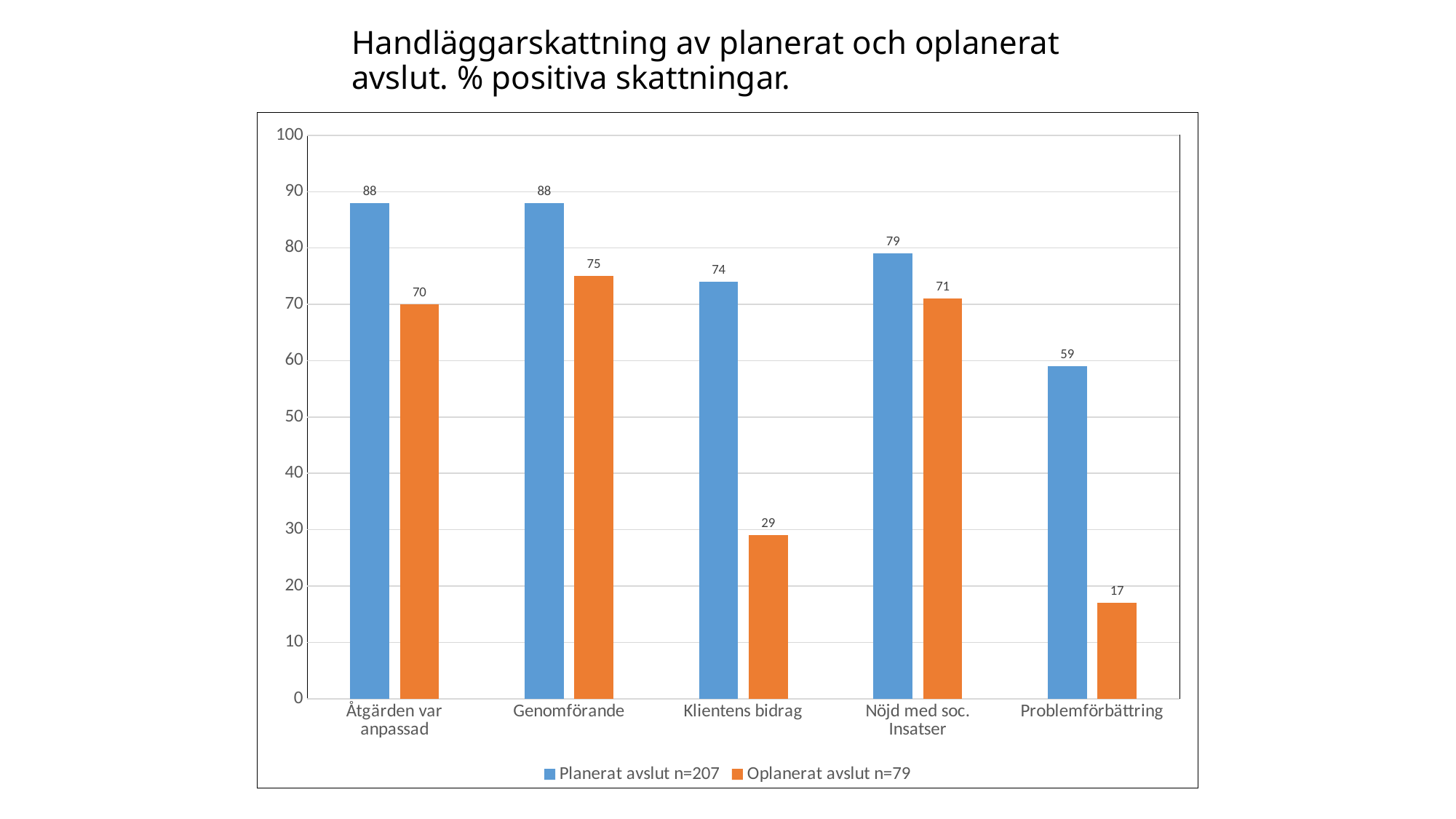
How many categories are shown on the x axis? 5 What is the value for Planerat avslut n=207 for Klientens bidrag? 74 What colour are the bars for Oplanerat avslut n=79? Orange Which category has the lowest value for Planerat avslut n=207? Problemförbättring Which category has the lowest value for Oplanerat avslut n=79? Problemförbättring What kind of chart is shown on the slide? Bar chart Which is larger for Åtgärden var anpassad: Planerat avslut n=207 or Oplanerat avslut n=79? Planerat avslut n=207 What is the difference between Planerat avslut n=207 and Oplanerat avslut n=79 for Genomförande? 13 How many series does the legend list? 2 What is the difference between Planerat avslut n=207 and Oplanerat avslut n=79 for Klientens bidrag? 45 What is the value for Oplanerat avslut n=79 for Nöjd med soc. Insatser? 71 What is the value for Oplanerat avslut n=79 for Problemförbättring? 17